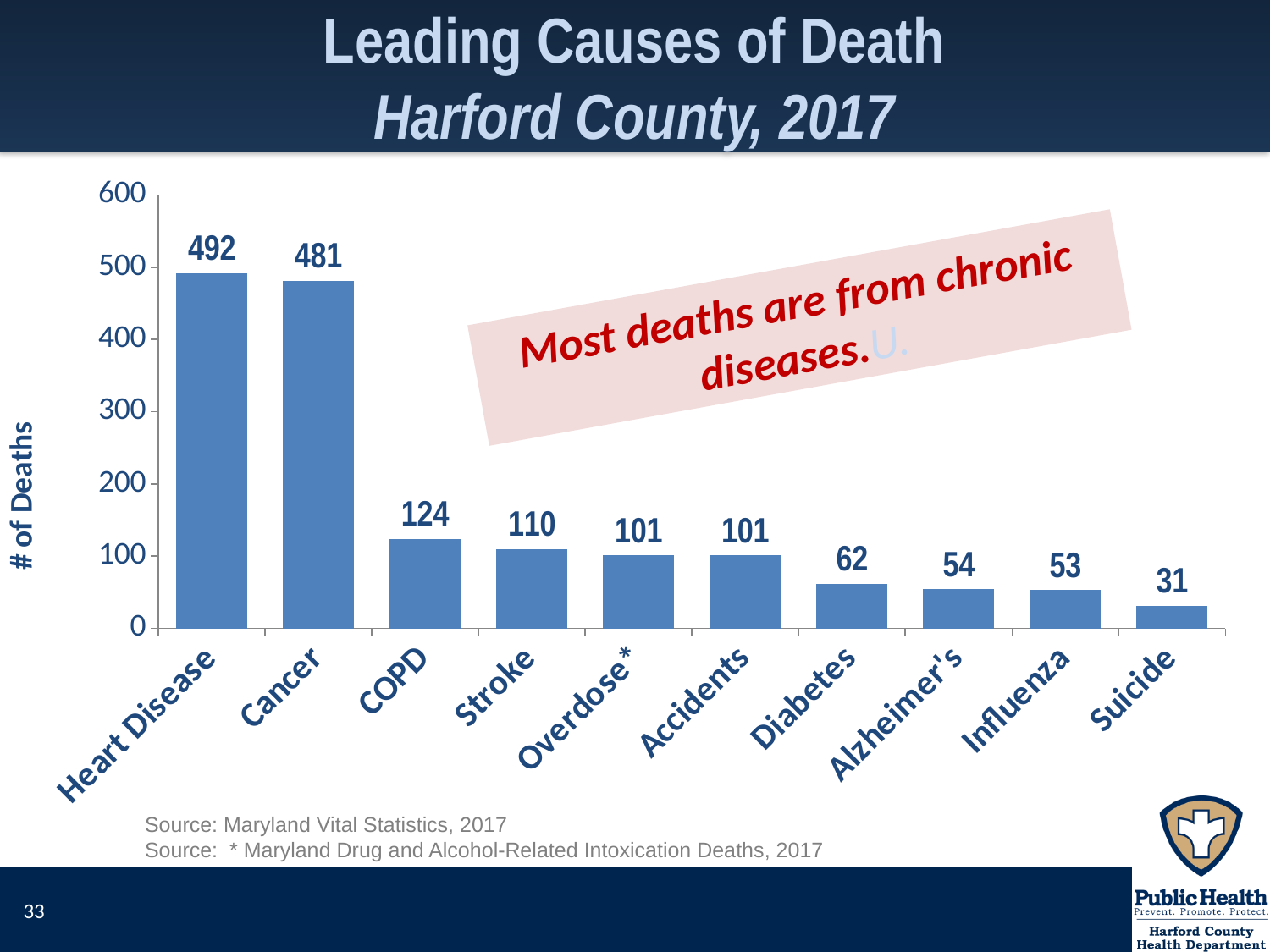
Is the value for Cancer greater or less than 400? greater What is the difference in deaths between COPD and Stroke? 14 How many deaths are shown for Heart Disease? 492 Which cause of death has the lowest number of deaths? Suicide What is the value shown for Diabetes? 62 How many causes of death are shown on the chart? 10 What kind of chart is shown on the slide? Bar chart Which cause of death has the highest number of deaths? Heart Disease What is the number of deaths for COPD? 124 What is the difference in deaths between Heart Disease and Cancer? 11 What is the label on the vertical axis of the chart? # of Deaths Which has more deaths, Alzheimer's or Diabetes? Diabetes